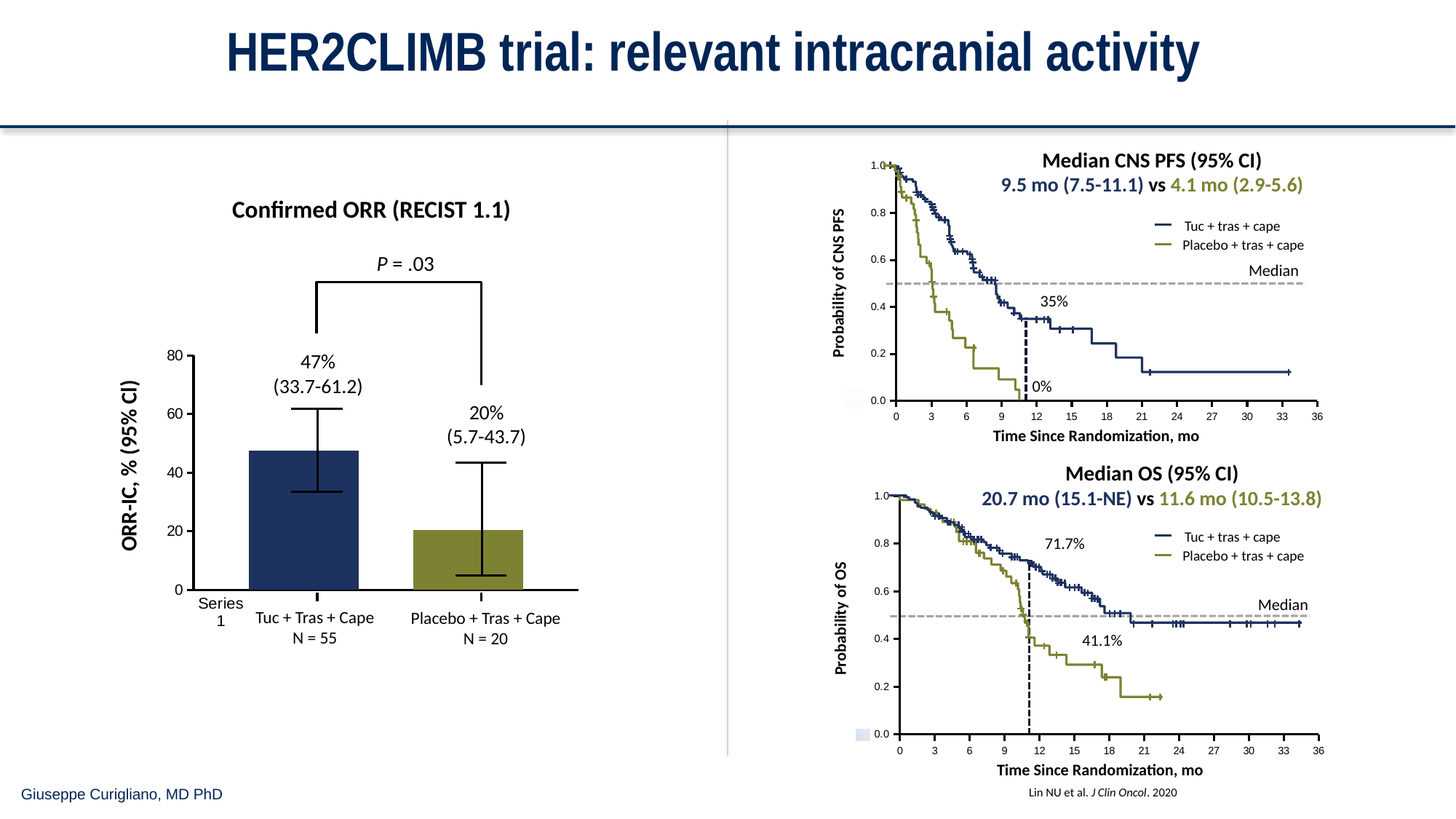
In the Confirmed ORR (RECIST 1.1) bar chart, what is the ORR-IC for Tuc + Tras + Cape? 47% In the Confirmed ORR (RECIST 1.1) bar chart, what is the P value shown for the comparison between the two arms? P = .03 In the Confirmed ORR (RECIST 1.1) bar chart, how many treatment arms are plotted? 2 What kind of chart is the Confirmed ORR (RECIST 1.1) chart on the left of the slide? Bar chart In the Median CNS PFS chart, what is the median CNS PFS for Placebo + tras + cape? 4.1 mo In the Median OS chart, what is the labelled probability of OS for the Tuc + tras + cape arm at the dashed vertical line? 71.7% In the Confirmed ORR (RECIST 1.1) bar chart, what is the difference in ORR-IC between Tuc + Tras + Cape and Placebo + Tras + Cape? 27% In the Median CNS PFS chart, what is the median CNS PFS for Tuc + tras + cape? 9.5 mo In the Median OS chart, what is the median OS for Placebo + tras + cape? 11.6 mo In the Median OS chart, how many series does the legend list? 2 In the Confirmed ORR (RECIST 1.1) bar chart, what is the ORR-IC for Placebo + Tras + Cape? 20% In the Confirmed ORR (RECIST 1.1) bar chart, which arm has the higher ORR-IC? Tuc + Tras + Cape